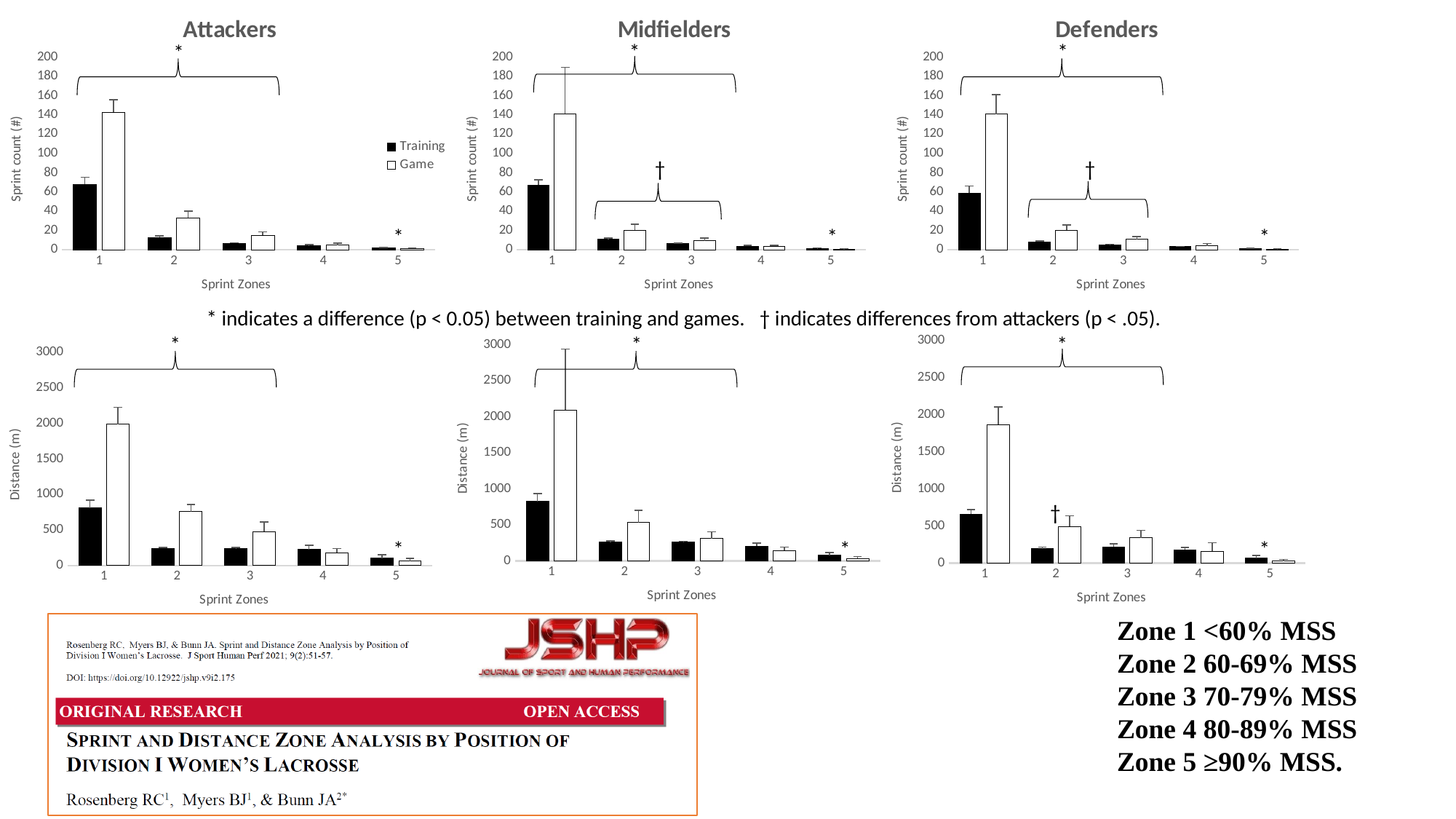
In the Midfielders sprint count chart, do the Game bars rise or fall from sprint zone 1 to sprint zone 5? fall What kind of chart is the Attackers sprint count chart at the top left? bar chart What are the two legend entries shown on the Attackers sprint count chart? Training and Game In the Defenders sprint count chart, which is larger for sprint zone 1, Training or Game? Game In the Attackers sprint count chart, is the Training value for sprint zone 1 greater or less than 80? less How many sprint zones are shown on the x axis of the Midfielders sprint count chart? 5 In the bottom-middle Distance chart (Midfielders), is the Training value for sprint zone 1 greater or less than 500? greater In the Attackers sprint count chart, which sprint zone has the highest Game bar? 1 In the bottom-left Distance chart (Attackers), is the Game value for sprint zone 1 greater or less than 1500? greater How many series does the legend on the Attackers sprint count chart list? 2 In the bottom-left Distance chart (Attackers), which is larger for sprint zone 5, Training or Game? Training